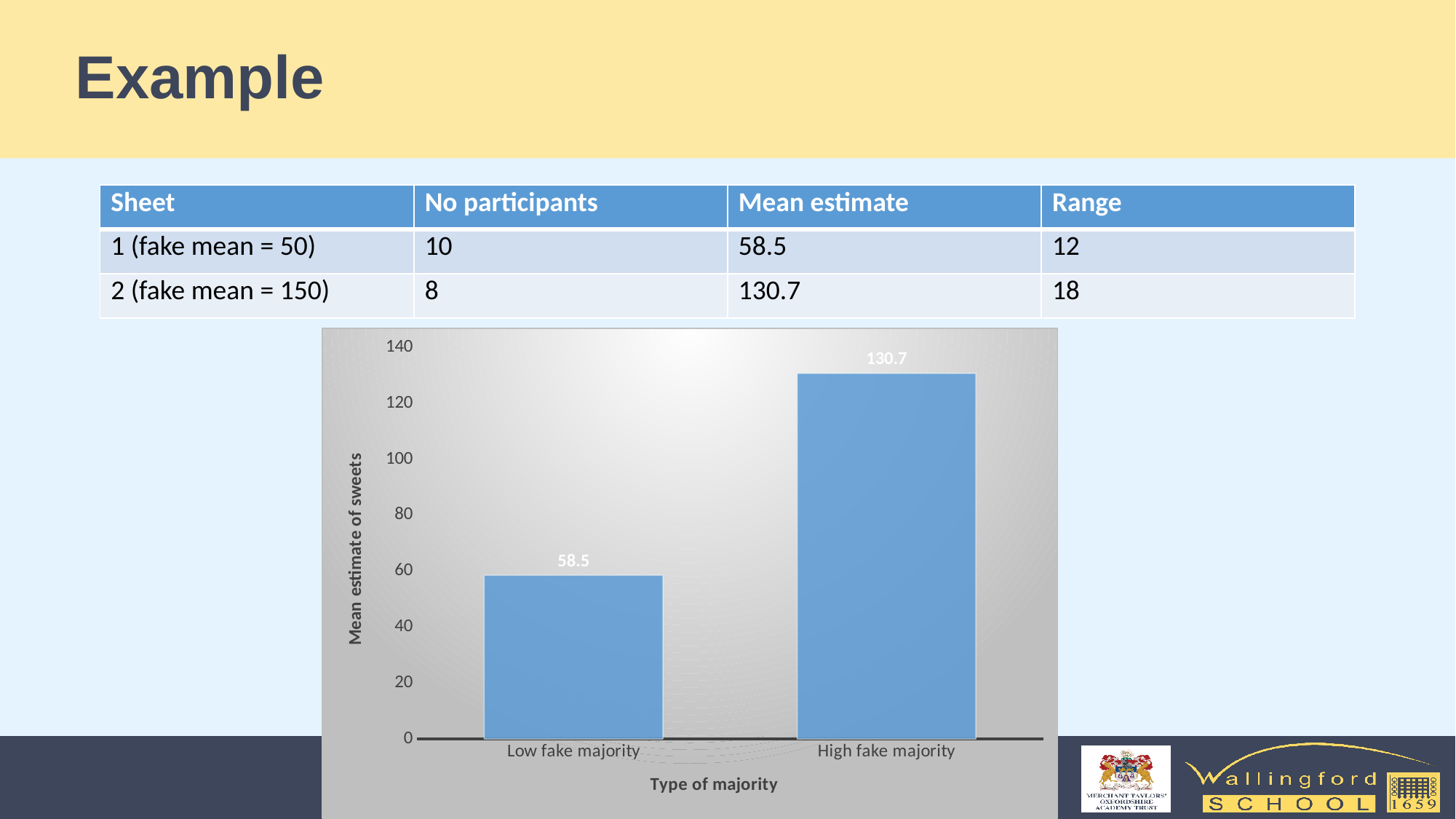
Is the value for the Low fake majority greater or less than 60? less Which type of majority has the lowest mean estimate of sweets? Low fake majority How many categories are shown on the x axis of the chart? 2 What is the difference between the mean estimates for the High fake majority and the Low fake majority? 72.2 What is the mean estimate of sweets for the High fake majority? 130.7 Which is larger, the mean estimate for the Low fake majority or the High fake majority? High fake majority Is the value for the High fake majority greater or less than 120? greater What is the label of the x axis of the chart? Type of majority Which type of majority has the highest mean estimate of sweets? High fake majority What is the mean estimate of sweets for the Low fake majority? 58.5 What is the label of the y axis of the chart? Mean estimate of sweets What kind of chart is shown on the slide? Bar chart